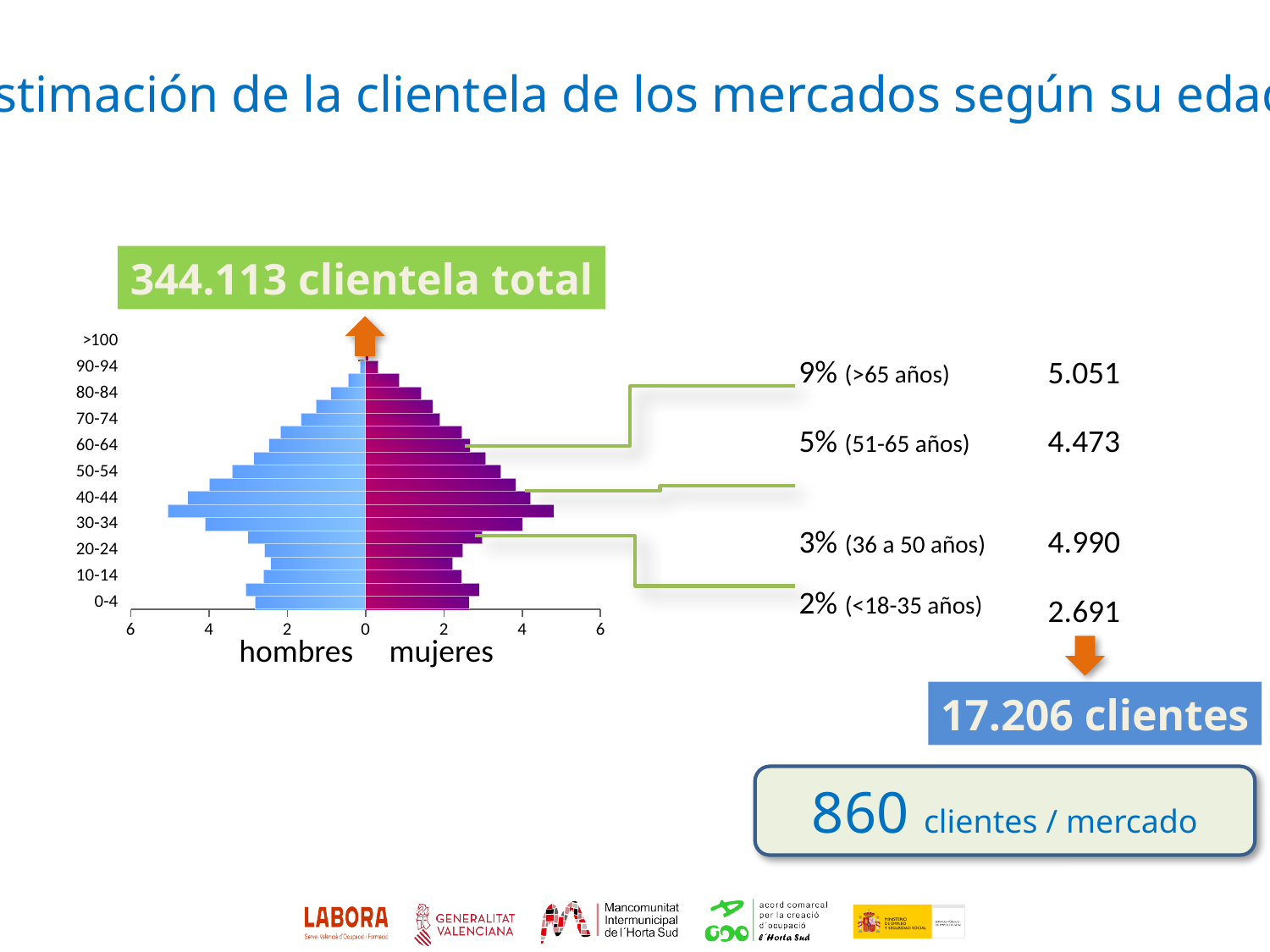
How many series does the chart show (labelled below the x axis)? 2 What are the two series labelled below the x axis of the chart? hombres, mujeres What number is given next to the 9% (>65 años) annotation? 5.051 Which is larger, the hombres bar for 30-34 or the hombres bar for 90-94? 30-34 What colour are the bars for hombres? blue What is the clientela total shown above the chart? 344.113 Is the value for hombres in the 0-4 age group greater or less than 2? greater What kind of chart is shown on the slide? bar chart Is the value for mujeres in the 80-84 age group greater or less than 2? less What percentage is given for the 51-65 años group? 5%